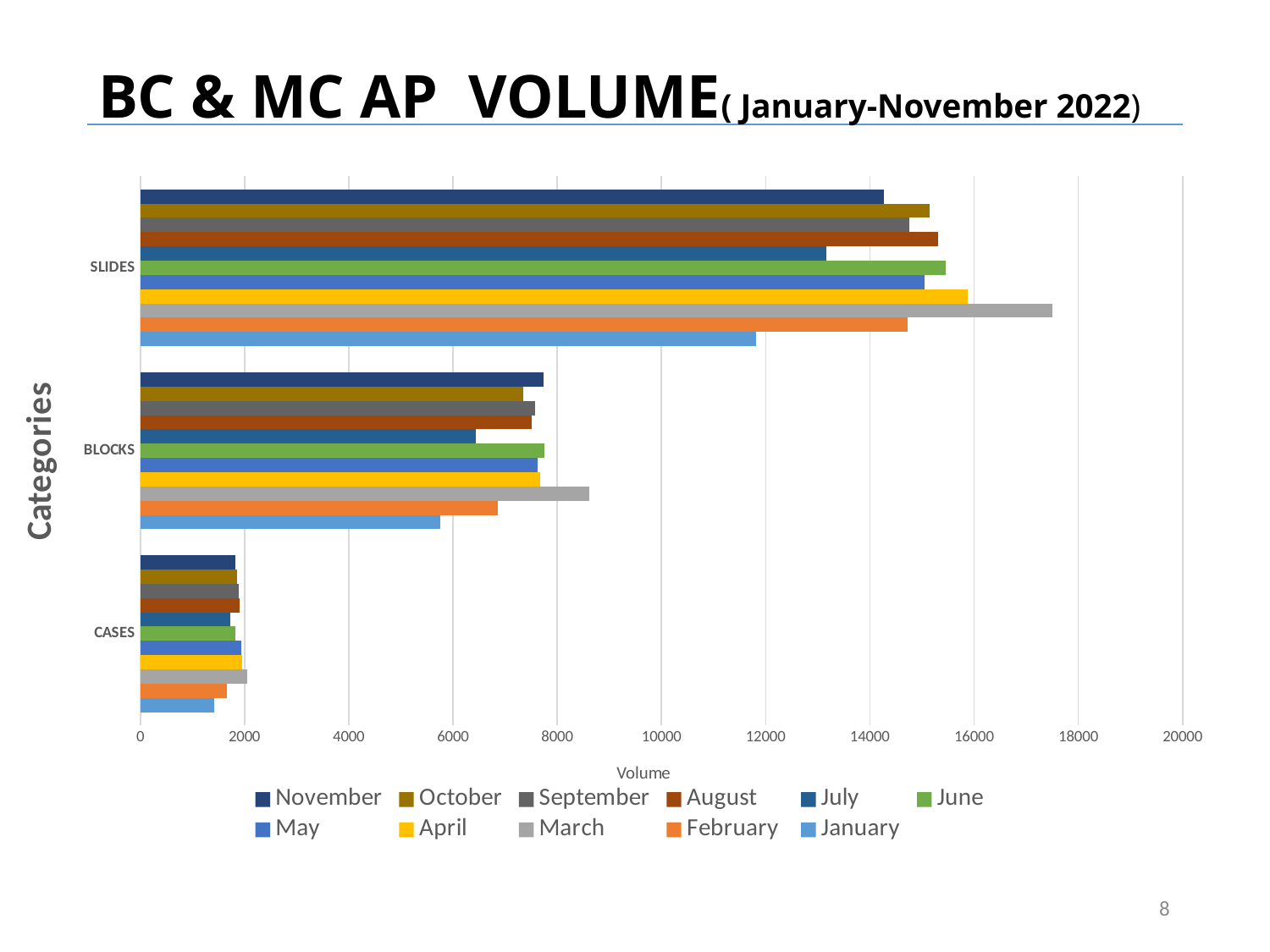
How many series (months) does the legend list? 11 For SLIDES, which month has the lowest volume? January For BLOCKS, which is larger: the volume for March or the volume for November? March For SLIDES, which month has the highest volume? March Is the BLOCKS volume for March greater or less than 8000? greater Which category has the lowest volumes overall? CASES Is the BLOCKS volume for January greater or less than 6000? less Is the SLIDES volume for March greater or less than 16000? greater Which category has the highest volumes overall? SLIDES What kind of chart is shown on the slide? bar chart How many categories are shown on the vertical axis of the chart? 3 What is the title of the horizontal axis? Volume